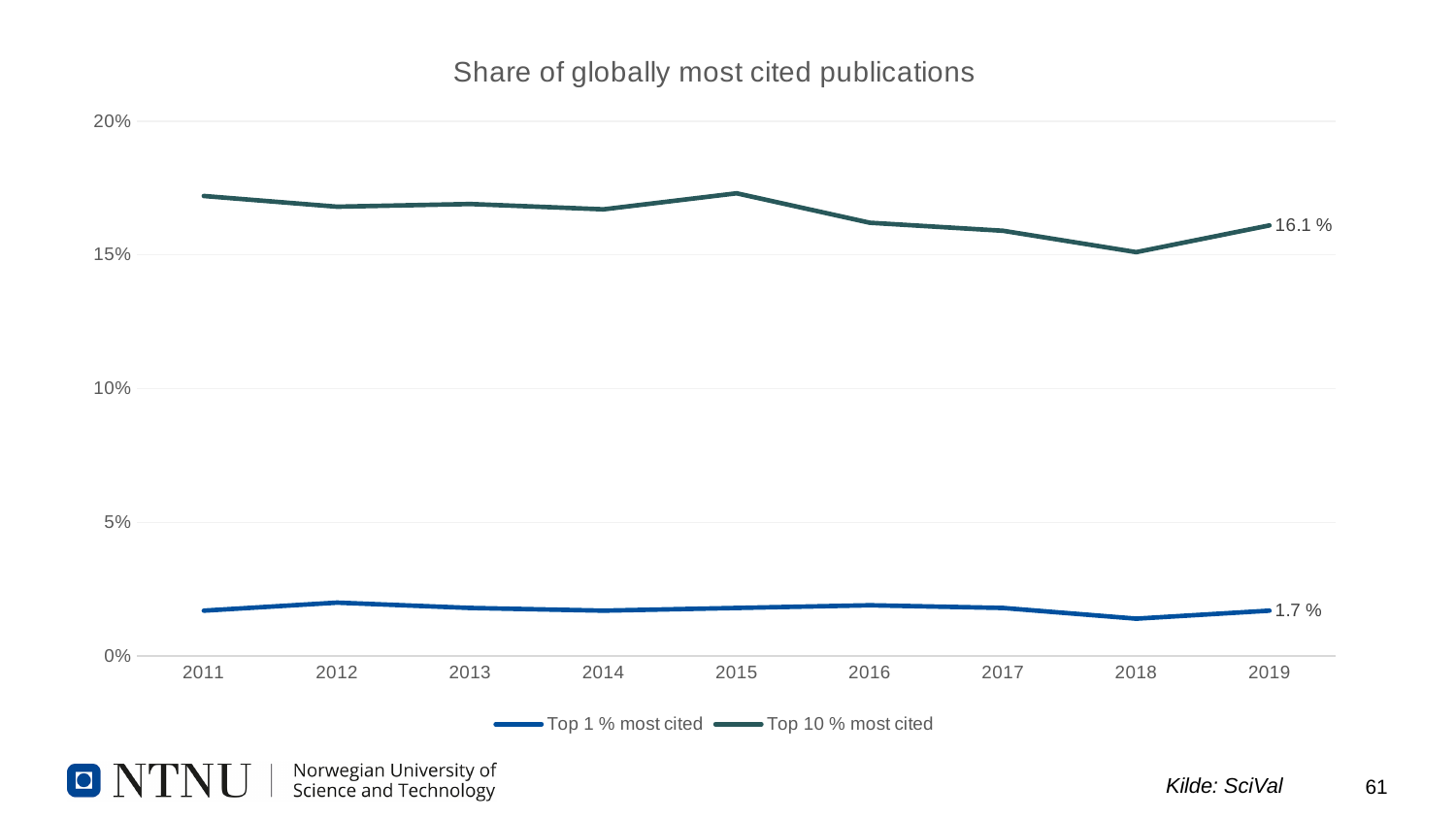
Which series has the higher value in 2019, Top 1 % most cited or Top 10 % most cited? Top 10 % most cited How many series does the legend list? 2 What is the value for Top 10 % most cited in 2019? 16.1 % In which year is the Top 1 % most cited series at its lowest? 2018 Is the value for Top 1 % most cited in 2012 greater or less than 5%? less What kind of chart is shown on the slide? Line chart Does the Top 10 % most cited series rise or fall from 2015 to 2018? Fall How many years are shown on the x axis? 9 What is the difference between the Top 10 % most cited and Top 1 % most cited values in 2019? 14.4 % What is the value for Top 1 % most cited in 2019? 1.7 % Is the value for Top 10 % most cited in 2015 greater or less than 15%? greater In which year is the Top 10 % most cited series at its lowest? 2018